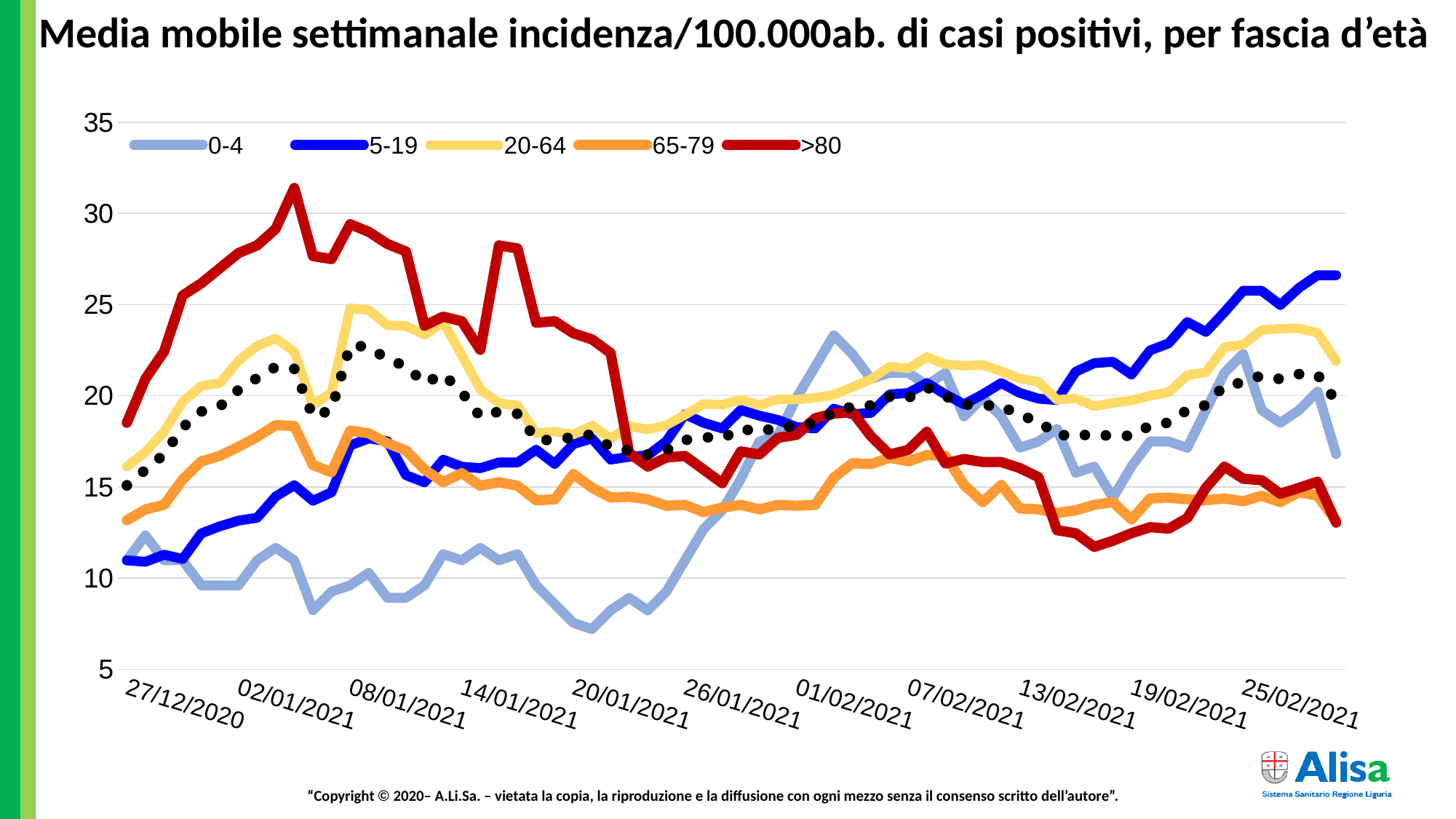
Is the value for the 65-79 series at 13/02/2021 greater or less than 15? less Which series has the lowest value at 14/01/2021? 0-4 Is the value for the >80 series at 02/01/2021 greater or less than 25? greater What is the title of the chart? Media mobile settimanale incidenza/100.000ab. di casi positivi, per fascia d'età How many series does the legend list? 5 Does the >80 series rise or fall between 02/01/2021 and 13/02/2021? fall At 27/12/2020, which series has the higher value: >80 or 0-4? >80 What kind of chart is shown on the slide? line chart Is the value for the 0-4 series at 20/01/2021 greater or less than 10? less Which series has the highest value at 27/12/2020? >80 At 25/02/2021, which series has the higher value: 5-19 or >80? 5-19